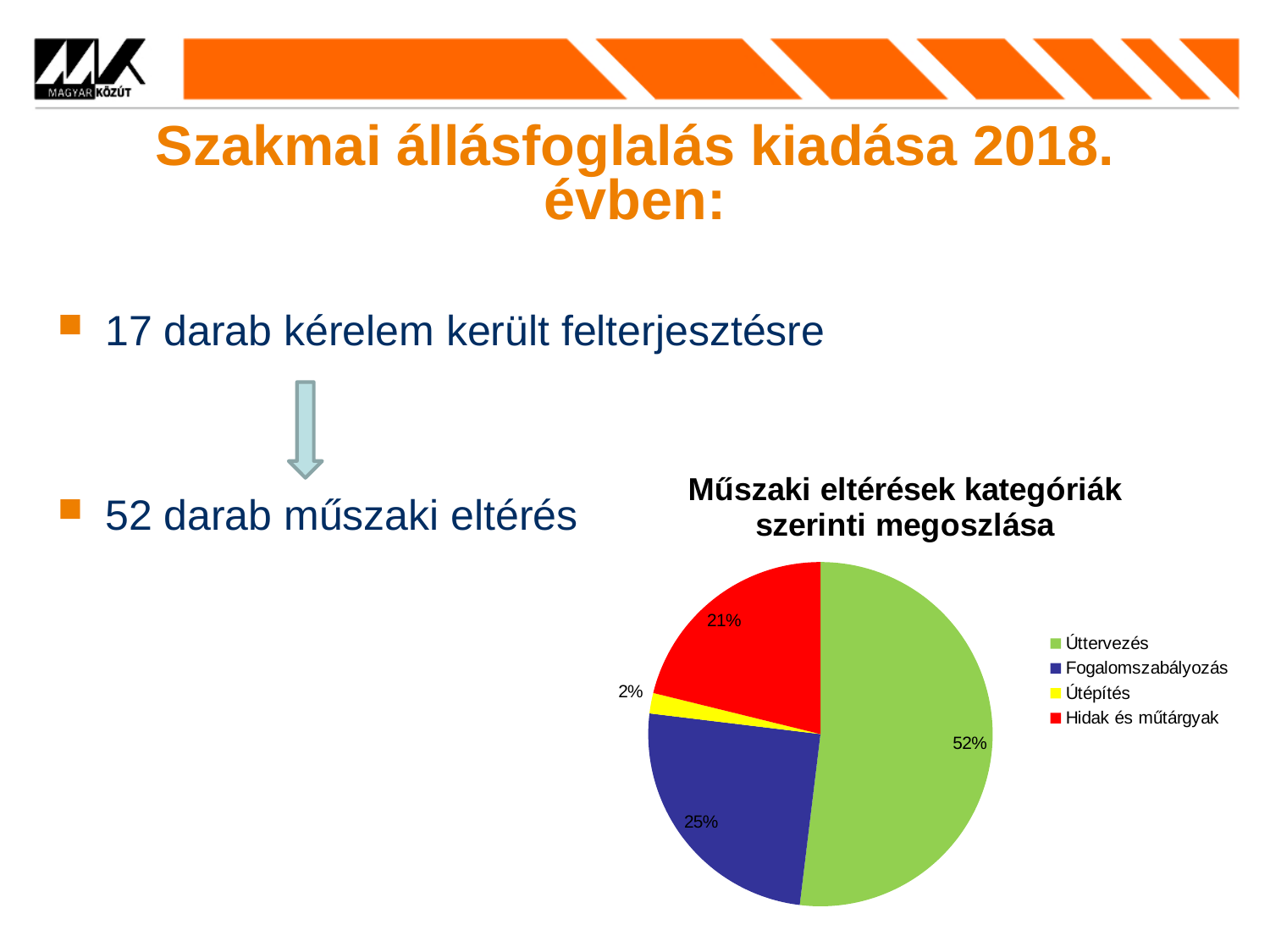
What share of the pie does Fogalomszabályozás have? 25% What kind of chart is shown on the slide? pie chart What share of the pie does Hidak és műtárgyak have? 21% Which is larger, the share for Fogalomszabályozás or the share for Hidak és műtárgyak? Fogalomszabályozás What is the title of the pie chart? Műszaki eltérések kategóriák szerinti megoszlása What share of the pie does Úttervezés have? 52% Which category has the largest slice of the pie? Úttervezés Which category has the smallest slice of the pie? Útépítés What colour is the slice for Hidak és műtárgyak? red What is the difference in percentage points between Úttervezés and Fogalomszabályozás? 27 How many categories does the pie chart show? 4 What share of the pie does Útépítés have? 2%